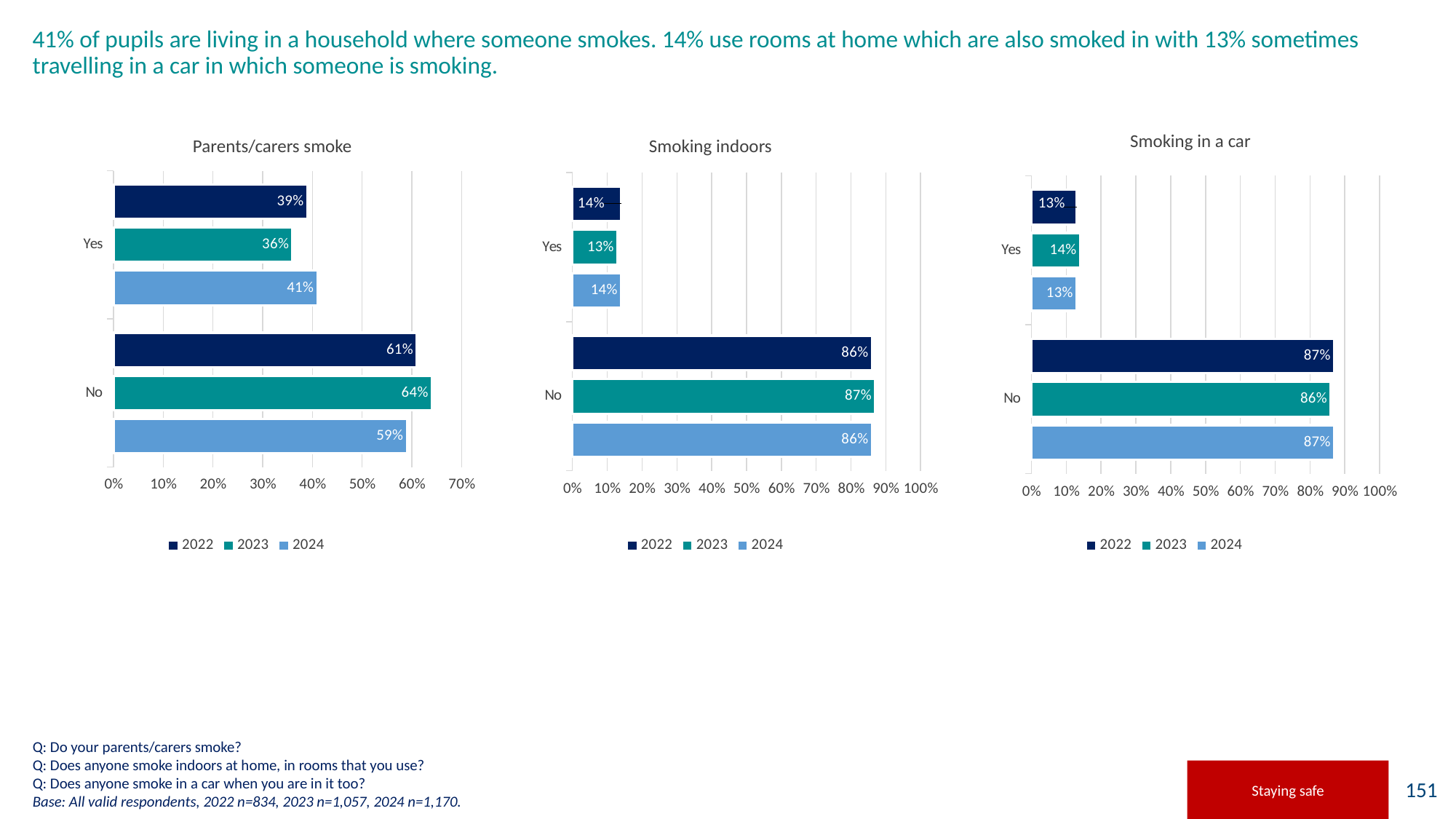
In the 'Parents/carers smoke' chart, what is the value for Yes in 2024? 41% In the 'Smoking indoors' chart, what is the value for Yes in 2022? 14% In the 'Smoking in a car' chart, which is larger: the Yes value for 2023 or the Yes value for 2024? 2023 In the 'Parents/carers smoke' chart, which year has the lowest value for No? 2024 In the 'Smoking in a car' chart, what is the value for No in 2024? 87% What type of chart is the 'Smoking in a car' chart? Bar chart How many charts are shown on the slide? 3 In the 'Parents/carers smoke' chart, what is the difference between the No and Yes values for 2022? 22% How many series does the legend list in the 'Smoking indoors' chart? 3 In the 'Parents/carers smoke' chart, what is the value for No in 2023? 64% In the 'Parents/carers smoke' chart, which year has the highest value for Yes? 2024 In the 'Smoking indoors' chart, what is the value for No in 2023? 87%